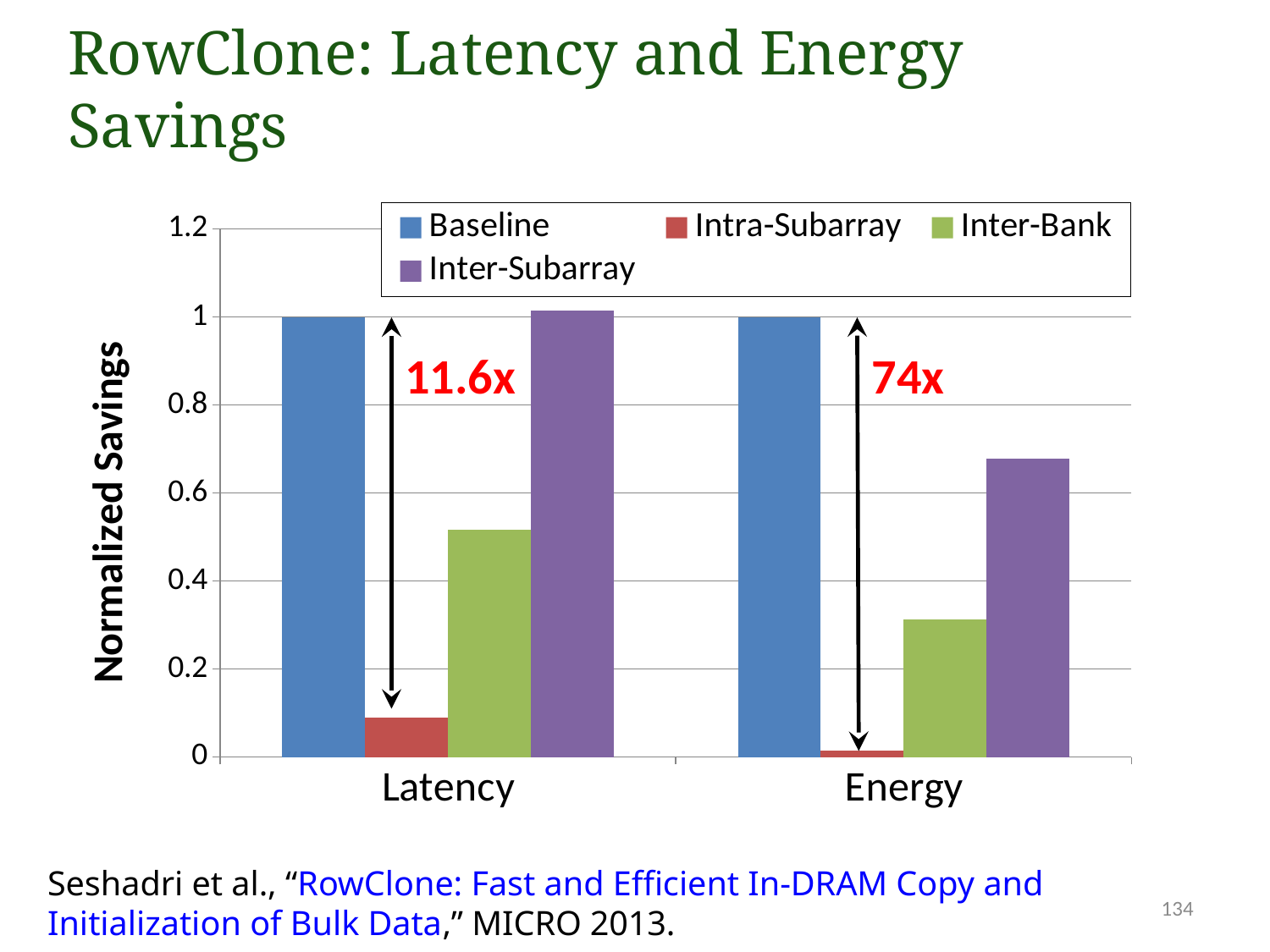
Which is larger, the Inter-Subarray value for Latency or the Inter-Subarray value for Energy? Latency How many series does the legend list? 4 What improvement factor is annotated between the Baseline and Intra-Subarray bars for Energy? 74x What kind of chart is shown on the slide? bar chart Which series has the highest value for Energy? Baseline How many categories are shown on the x axis? 2 Is the Inter-Bank value for Energy greater or less than 0.4? less What is the title of the y axis? Normalized Savings Is the Inter-Subarray value for Energy greater or less than 0.6? greater Is the Inter-Bank value for Latency greater or less than 0.4? greater What is the Baseline value for Latency? 1 Which series has the lowest value for Latency? Intra-Subarray